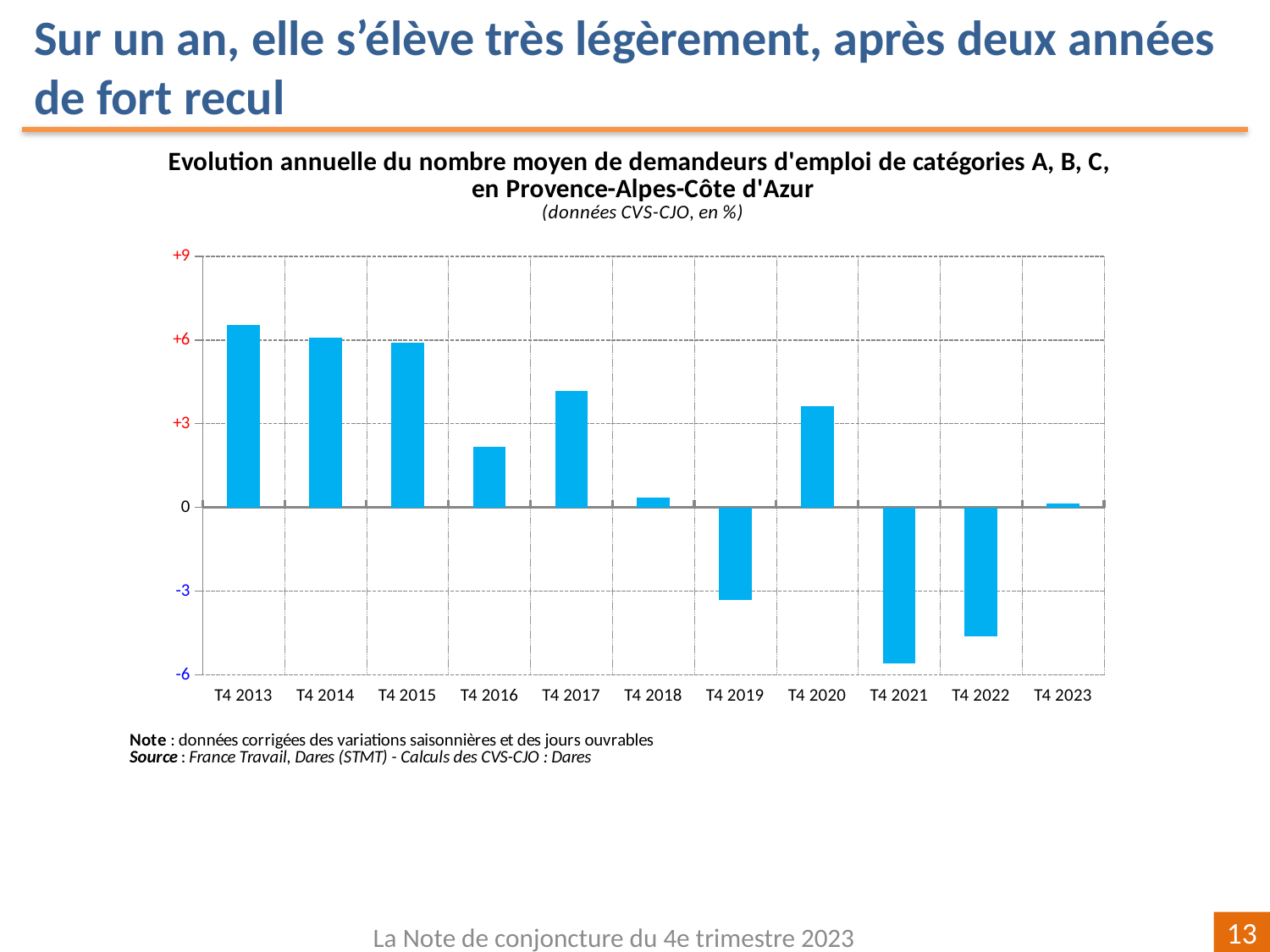
Do the values rise or fall from T4 2013 to T4 2016? fall Is the value for T4 2017 greater or less than +3? greater How many quarters (categories) are plotted on the x axis? 11 Is the value for T4 2016 greater or less than +3? less Which is larger, the value for T4 2021 or the value for T4 2022? T4 2022 Is the value for T4 2021 greater or less than -3? less Which quarter has the lowest value? T4 2021 Which is larger, the value for T4 2016 or the value for T4 2017? T4 2017 Which quarter has the highest value? T4 2013 In what unit are the data expressed, according to the chart subtitle? en % What kind of chart is shown on the slide? bar chart